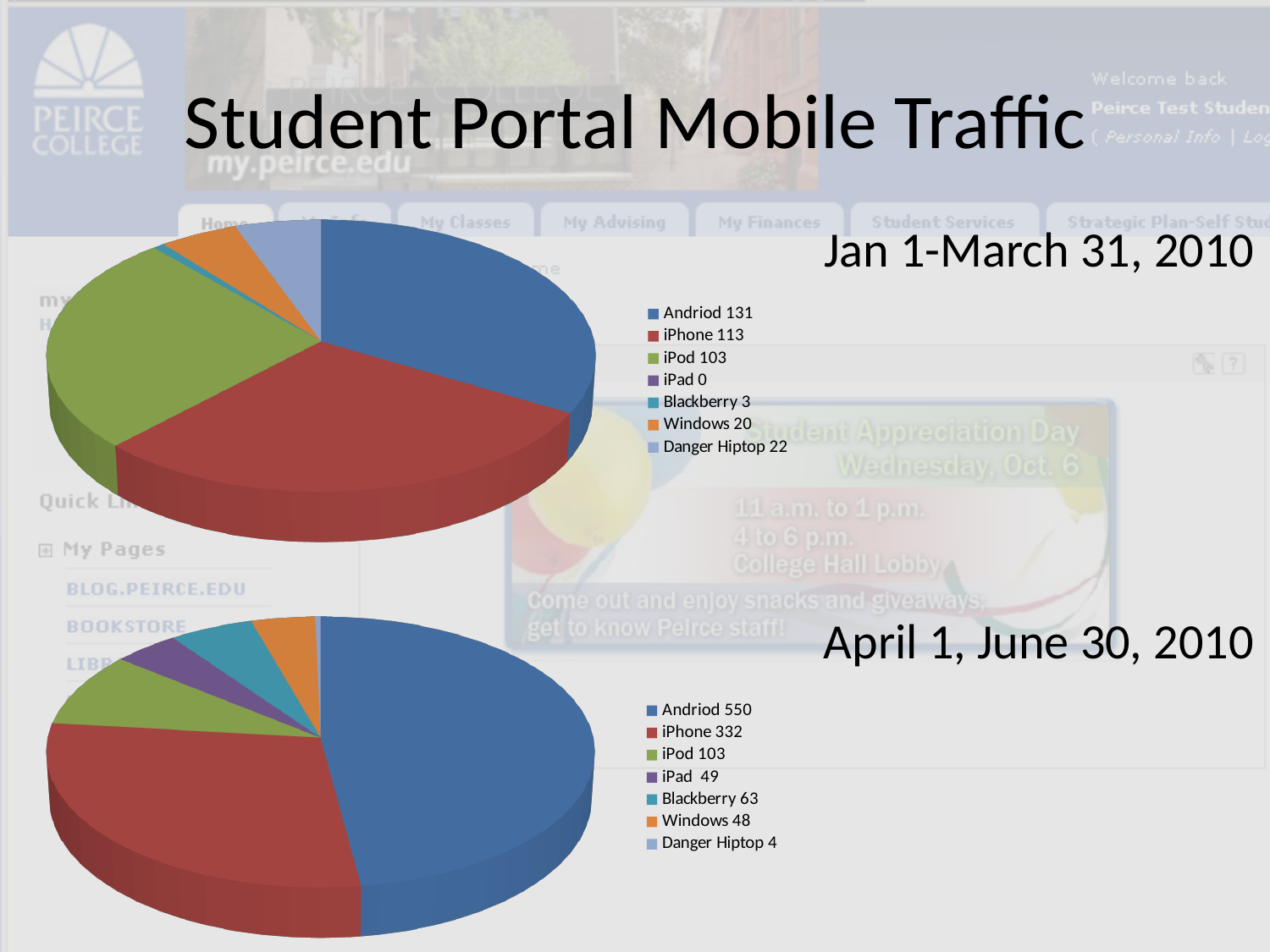
In the April 1, June 30, 2010 chart, what is the value for Blackberry? 63 In the April 1, June 30, 2010 chart, which is larger, iPad or Windows? iPad In the April 1, June 30, 2010 chart, which category has the lowest value? Danger Hiptop In the Jan 1-March 31, 2010 chart, what is the value for iPhone? 113 What is the title of the slide containing the two charts? Student Portal Mobile Traffic What kind of chart is the April 1, June 30, 2010 chart? Pie chart In the Jan 1-March 31, 2010 chart, which category has the lowest value? iPad In the April 1, June 30, 2010 chart, what is the value for Danger Hiptop? 4 In the Jan 1-March 31, 2010 chart, which category has the highest value? Andriod How many categories does the legend of the Jan 1-March 31, 2010 chart list? 7 In the April 1, June 30, 2010 chart, what is the difference between the Andriod and iPhone values? 218 In the Jan 1-March 31, 2010 chart, what is the difference between the Danger Hiptop and Windows values? 2